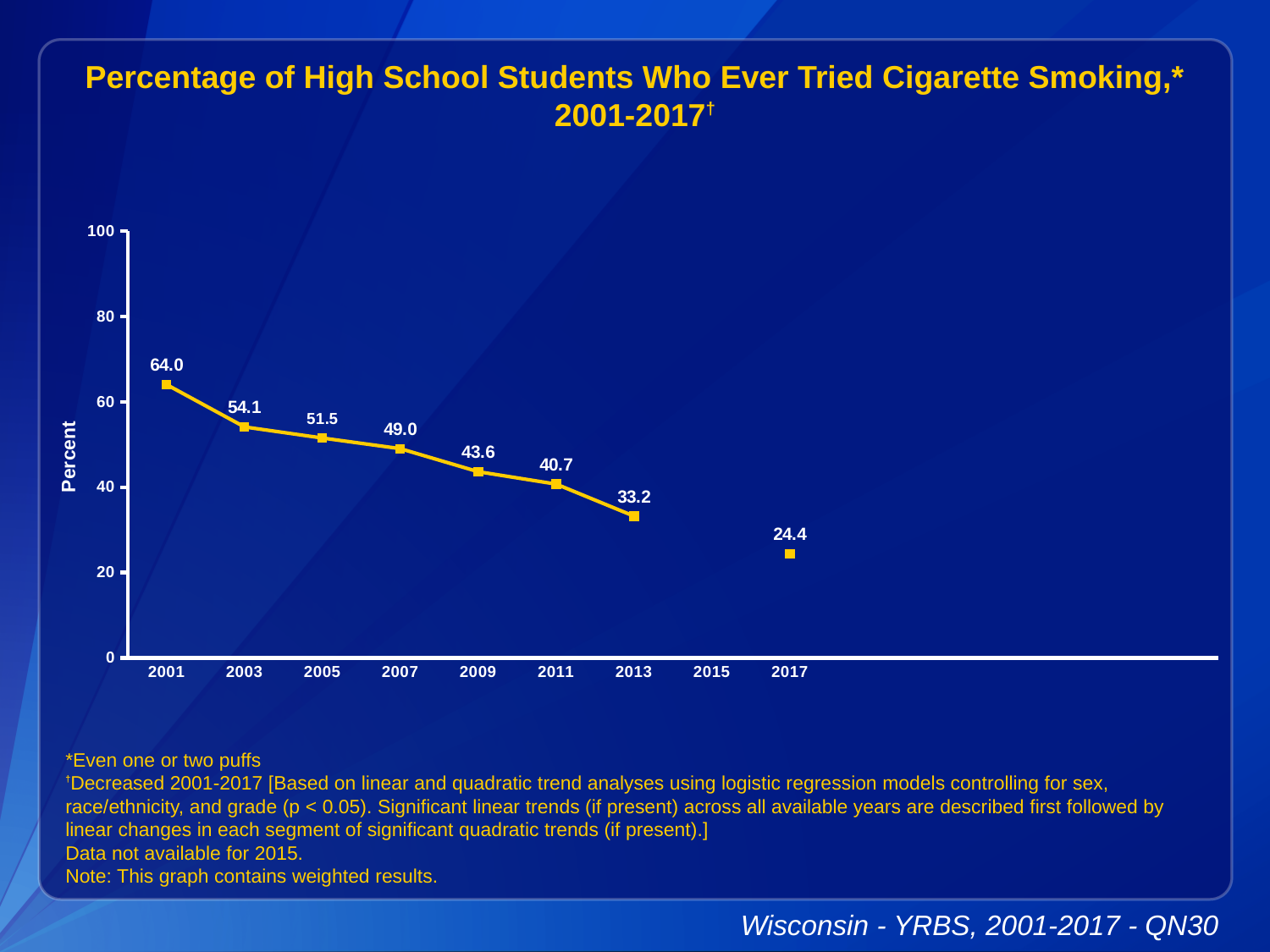
Which year has the lowest percentage of students who ever tried cigarette smoking? 2017 What was the percentage of high school students who ever tried cigarette smoking in 2001? 64.0 How many years have a plotted data point on the chart? 8 What is the difference between the 2001 value and the 2017 value? 39.6 What was the percentage of high school students who ever tried cigarette smoking in 2017? 24.4 Which is larger, the value for 2005 or the value for 2007? 2005 Is the value for 2003 greater or less than 60? less Do the values rise or fall from 2001 to 2017? fall What value is shown for 2009? 43.6 Which year has the highest percentage of students who ever tried cigarette smoking? 2001 What kind of chart is shown on the slide? line chart What is the difference between the 2011 value and the 2013 value? 7.5